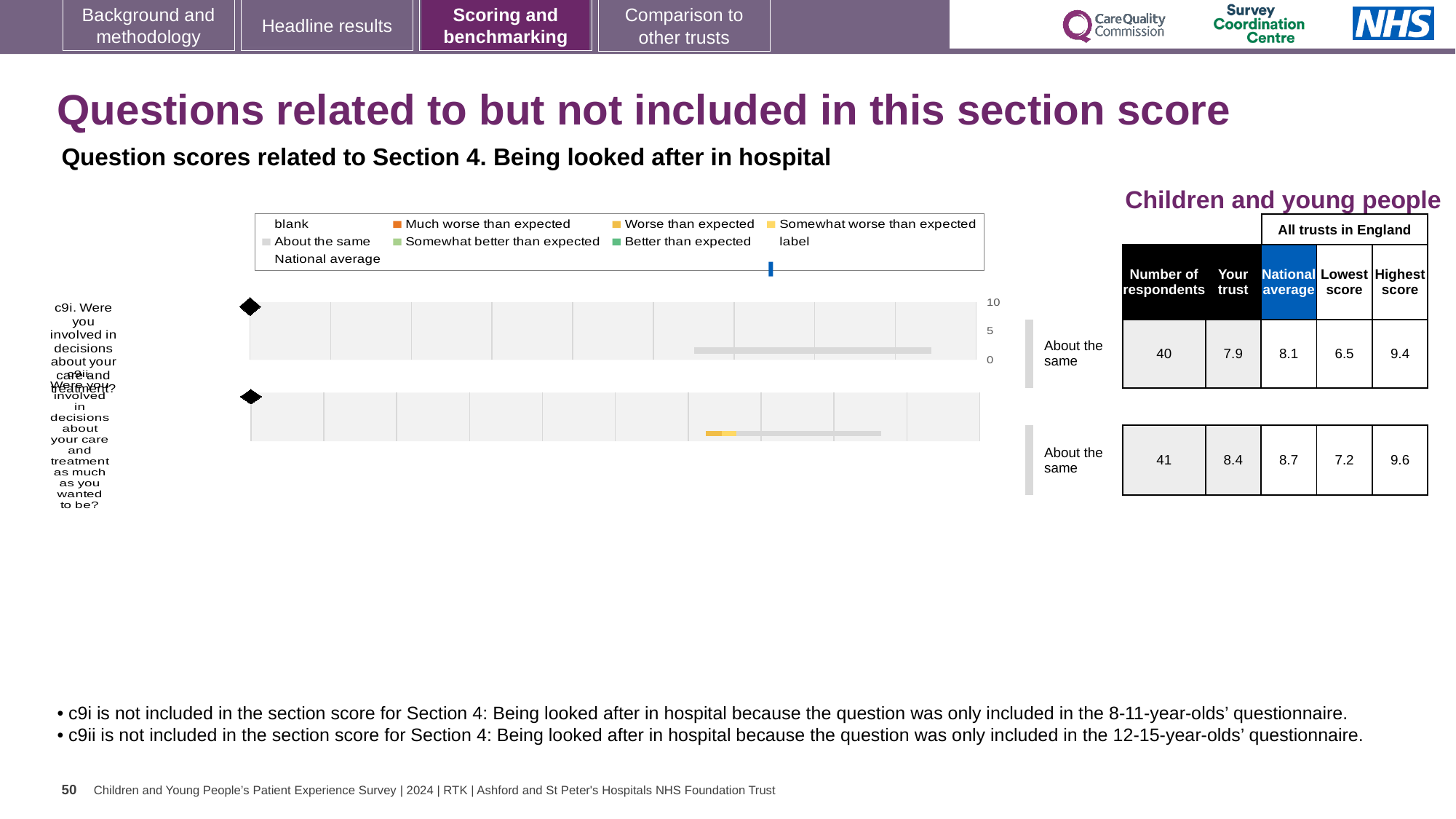
Which question has the higher 'Your trust' score, c9i or c9ii? c9ii What is the highest score among all trusts in England for question c9ii? 9.6 What kind of chart is used to show the question scores? Bar chart What is the maximum value shown on the score axis of the charts? 10 How many respondents answered question c9i? 40 What is the national average score for question c9ii? 8.7 What is the lowest score among all trusts in England for question c9i? 6.5 How many questions are plotted on the slide? 2 What benchmark category is shown for question c9i? About the same By how much does the national average exceed the 'Your trust' score for question c9i? 0.2 What is the difference between the highest and lowest scores for question c9ii? 2.4 What is the 'Your trust' score for question c9i? 7.9